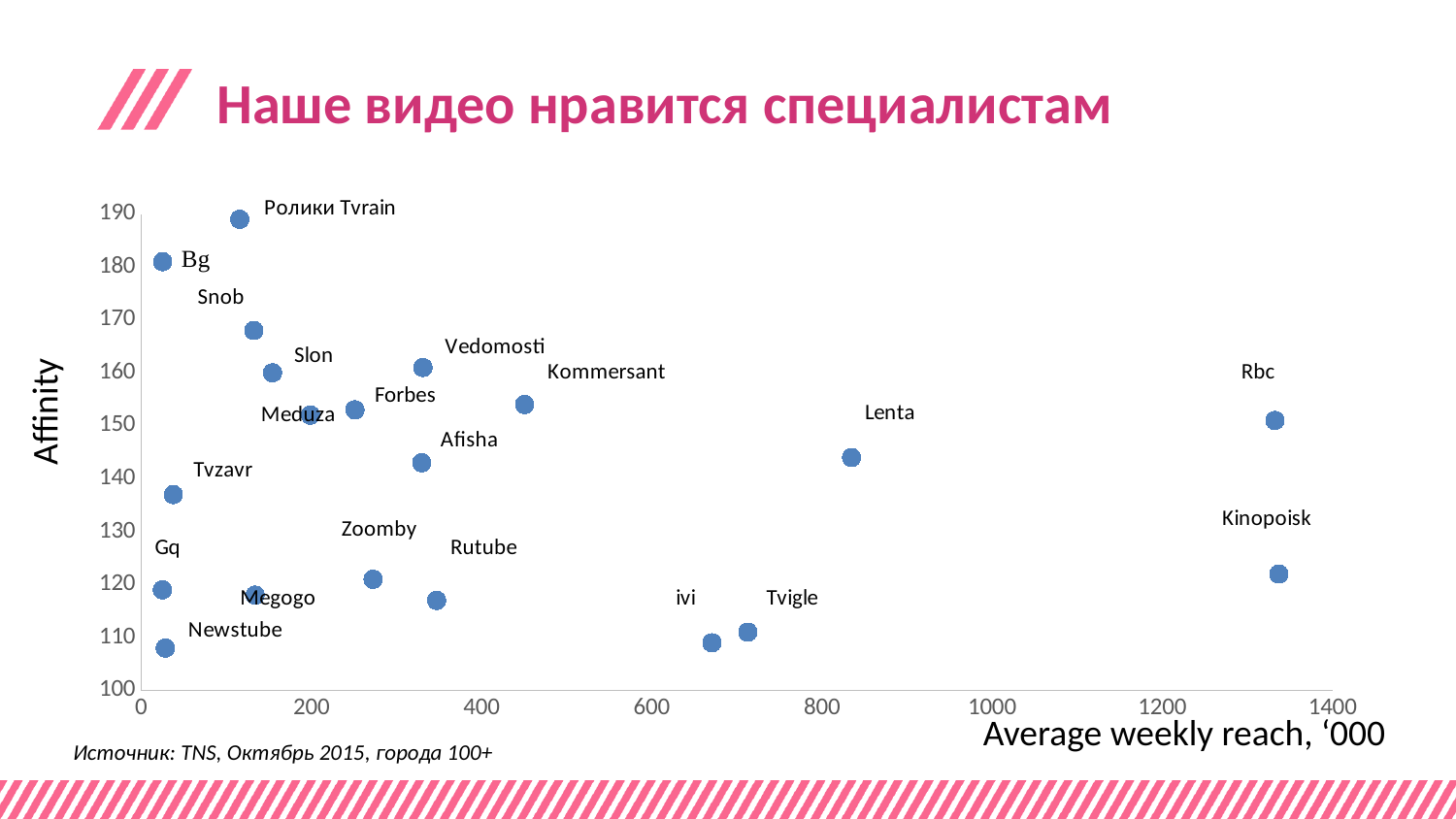
Is the Affinity value for Snob greater or less than 160? greater Is the Average weekly reach for Lenta greater or less than 800? greater Is the Affinity value for Kinopoisk greater or less than 130? less Which point has the highest Affinity value? Ролики Tvrain What is the label of the horizontal axis of the chart? Average weekly reach, '000 Which has the higher Affinity value, Rbc or Kinopoisk? Rbc Which has the greater Average weekly reach, Lenta or Kommersant? Lenta Which point has the lowest Affinity value? Newstube What kind of chart is shown on the slide? scatter chart